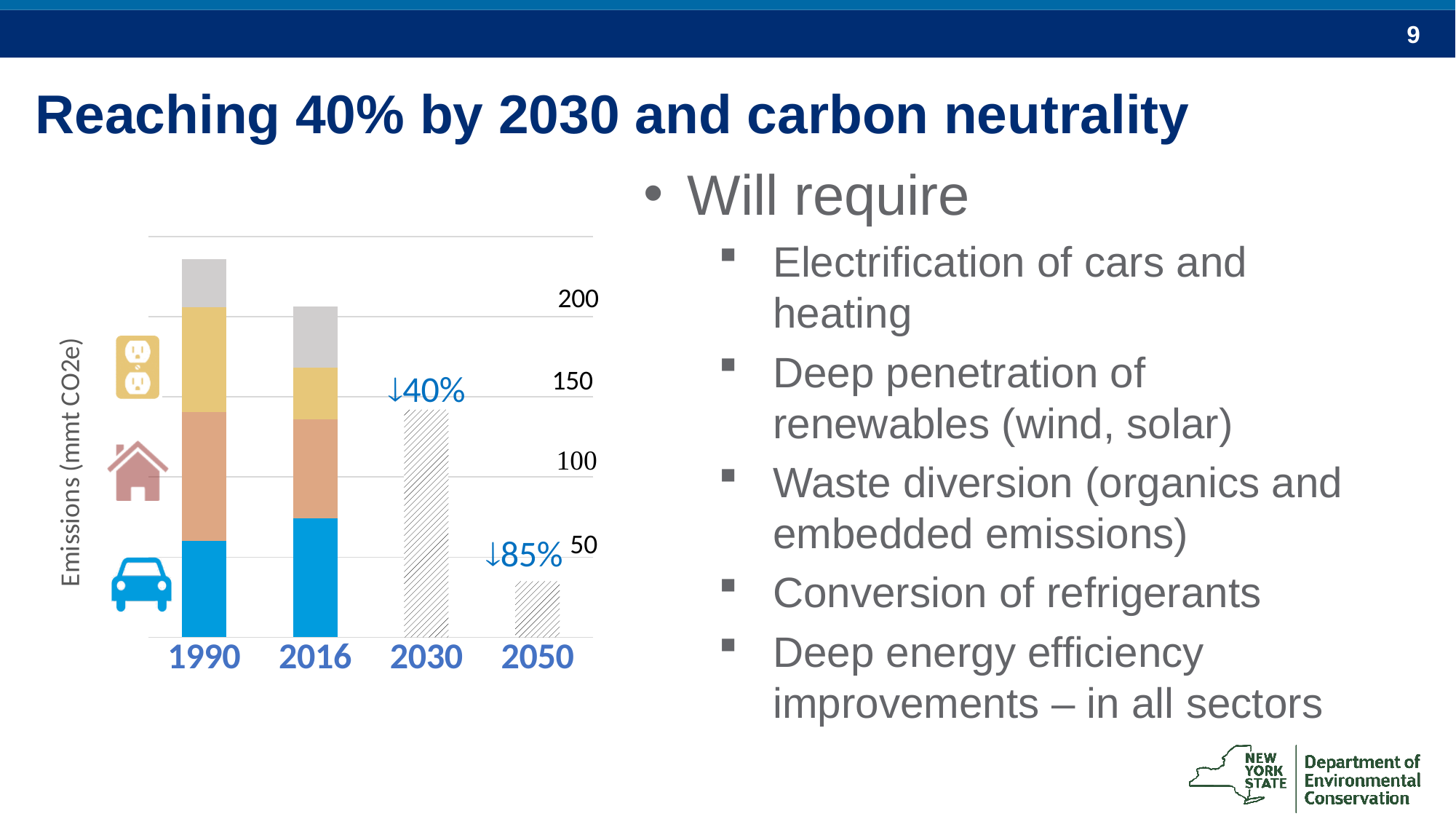
What kind of chart is shown on the slide? Stacked bar chart Is the emissions bar for 2050 greater or less than 50? less How many years are shown along the x axis of the chart? 4 Is the emissions bar for 2030 greater or less than 100? greater Which year has the highest total emissions bar in the chart? 1990 Which year has the taller total emissions bar, 1990 or 2016? 1990 What percentage reduction is labelled above the 2050 bar? 85% What percentage reduction is labelled above the 2030 bar? 40% What is the title of the chart's vertical axis? Emissions (mmt CO2e) Do the emissions bars rise or fall from 1990 to 2050? fall Is the total emissions bar for 1990 greater or less than 200? greater Which year has the lowest emissions bar in the chart? 2050